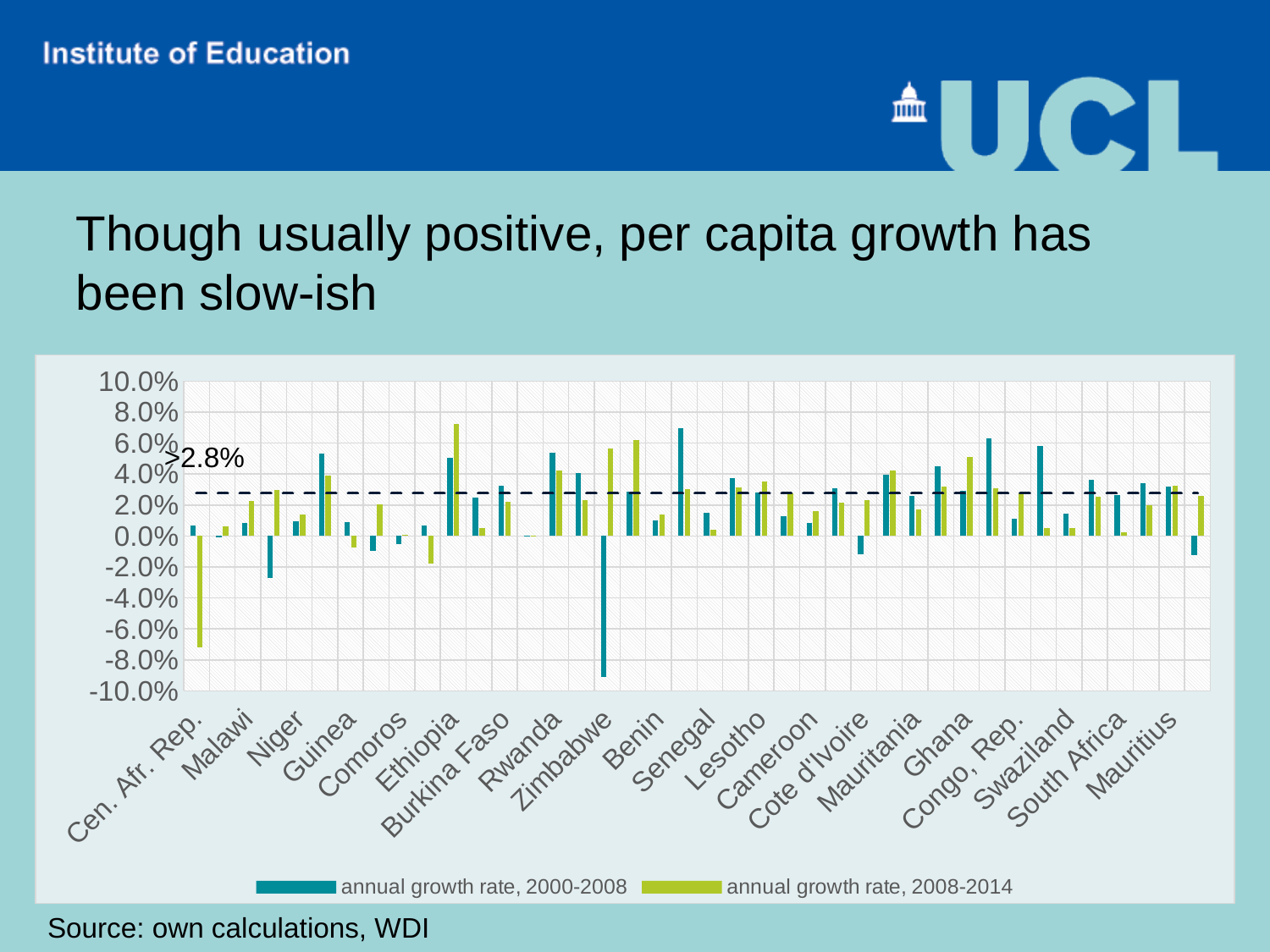
How many series does the legend list? 2 Which country has the lowest annual growth rate for 2000-2008? Zimbabwe Which is larger for Zimbabwe: the annual growth rate for 2000-2008 or for 2008-2014? 2008-2014 What are the two series named in the legend? annual growth rate, 2000-2008 and annual growth rate, 2008-2014 Which is larger for Ethiopia: the annual growth rate for 2000-2008 or for 2008-2014? 2008-2014 Is the annual growth rate for Zimbabwe in 2000-2008 greater or less than -8.0%? less Is the annual growth rate for Cen. Afr. Rep. in 2008-2014 greater or less than -6.0%? less What kind of chart is shown on the slide? bar chart Is the annual growth rate for Senegal in 2000-2008 greater or less than 6.0%? less Which is larger for Cen. Afr. Rep.: the annual growth rate for 2000-2008 or for 2008-2014? 2000-2008 What value is marked by the dashed horizontal line on the chart? 2.8%